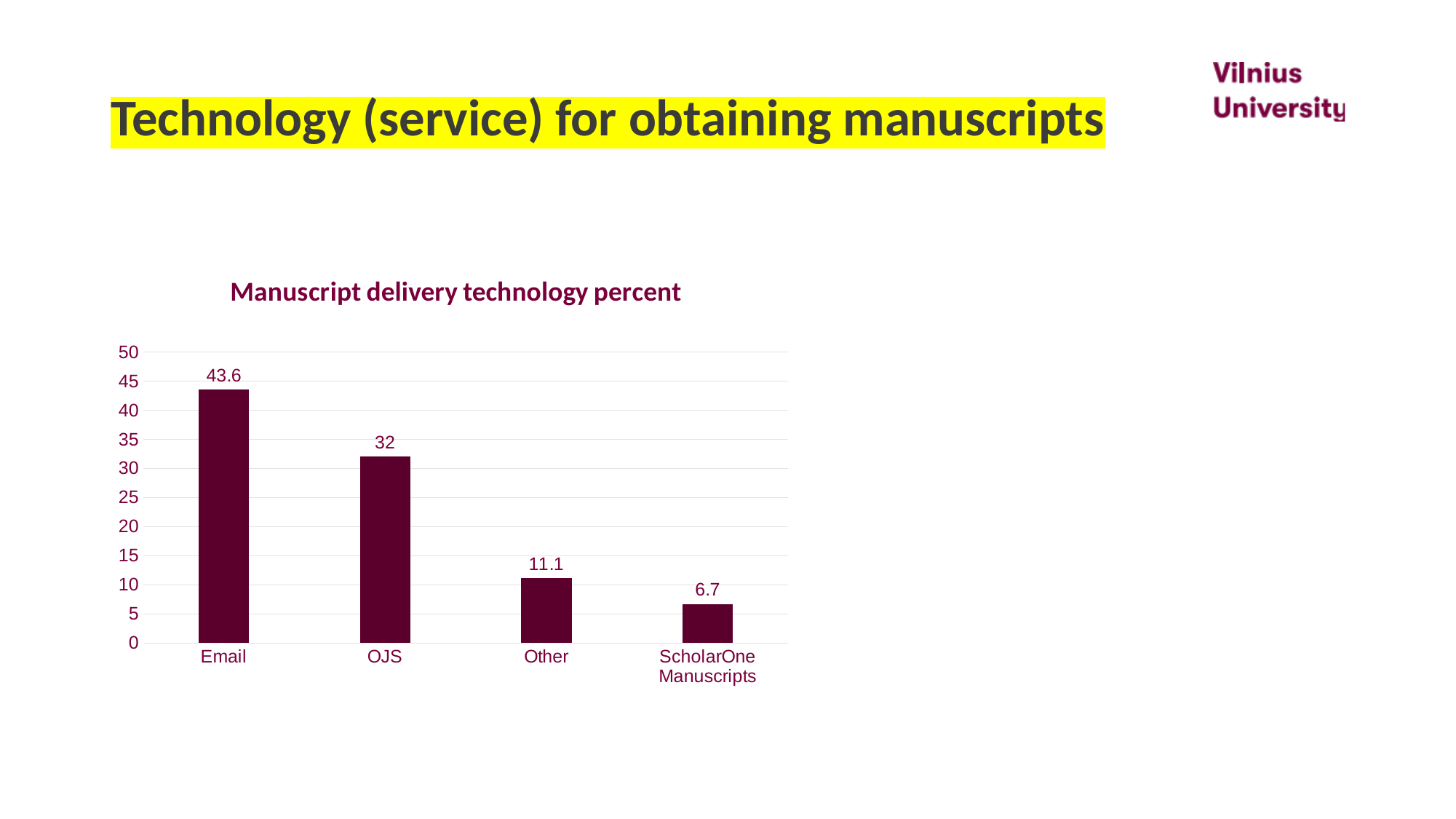
How many categories are shown in the chart? 4 What kind of chart is shown on the slide? Bar chart What is the difference between the values for Email and OJS? 11.6 Which category has the highest value? Email Which category has the lowest value? ScholarOne Manuscripts What is the difference between the values for Other and ScholarOne Manuscripts? 4.4 What is the value for OJS? 32 What is the value for Email? 43.6 What is the value for ScholarOne Manuscripts? 6.7 What is the value for Other? 11.1 What is the title of the chart? Manuscript delivery technology percent Which is larger, the value for OJS or the value for Other? OJS